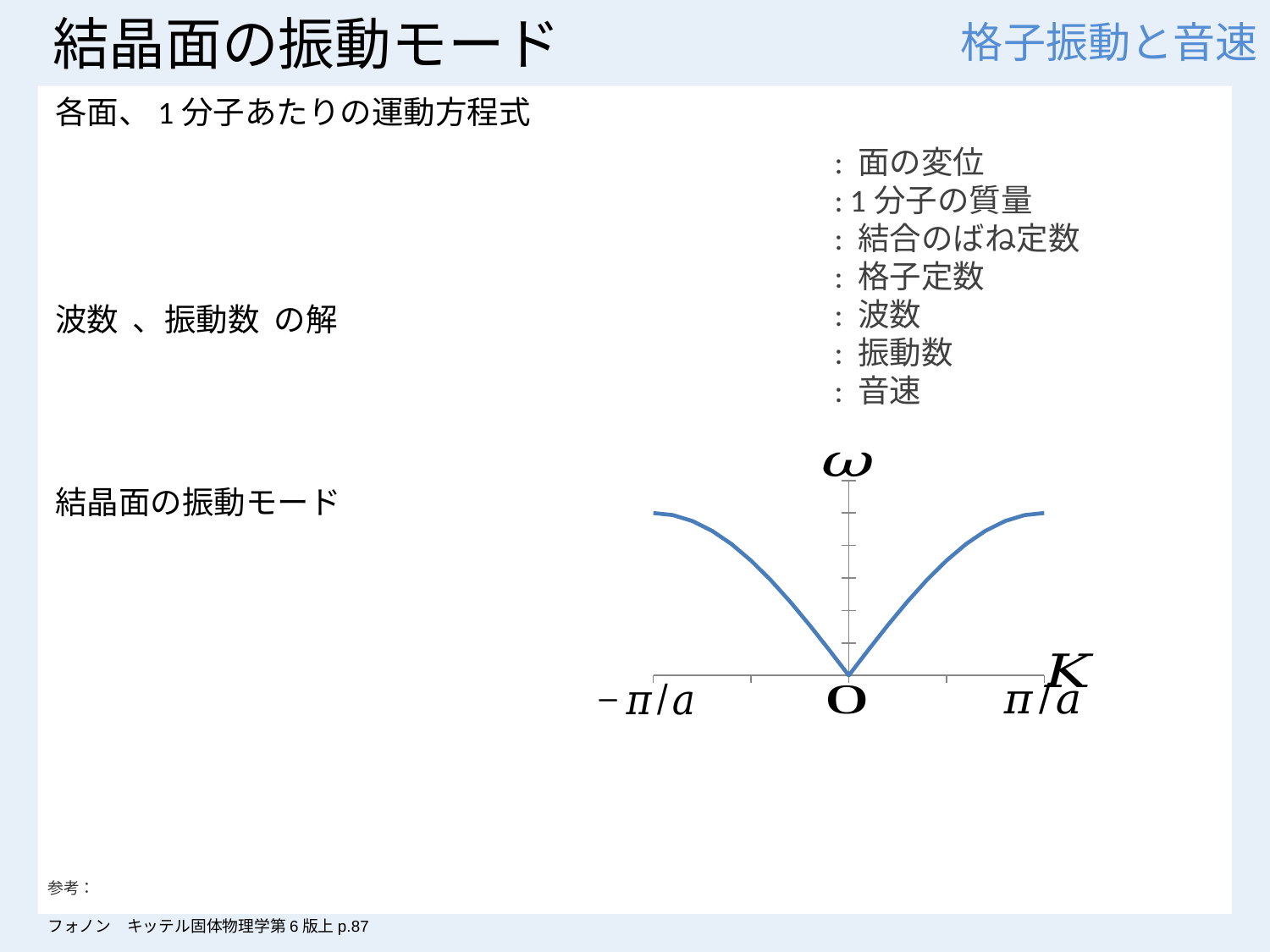
Is the value of ω at K = π/a greater or less than the value at K = 0? greater Does the curve rise or fall as K increases from 0 to π/a? rise At which value of K does the curve reach its lowest point? 0 Does the curve rise or fall as K increases from -π/a to 0? fall How many curves are plotted on the chart? 1 What kind of chart is shown on the slide? line chart What symbol labels the horizontal axis of the chart? K What is the label at the left end of the horizontal axis? -π/a What symbol labels the vertical axis of the chart? ω Is the value of ω at K = -π/a greater or less than the value at K = 0? greater